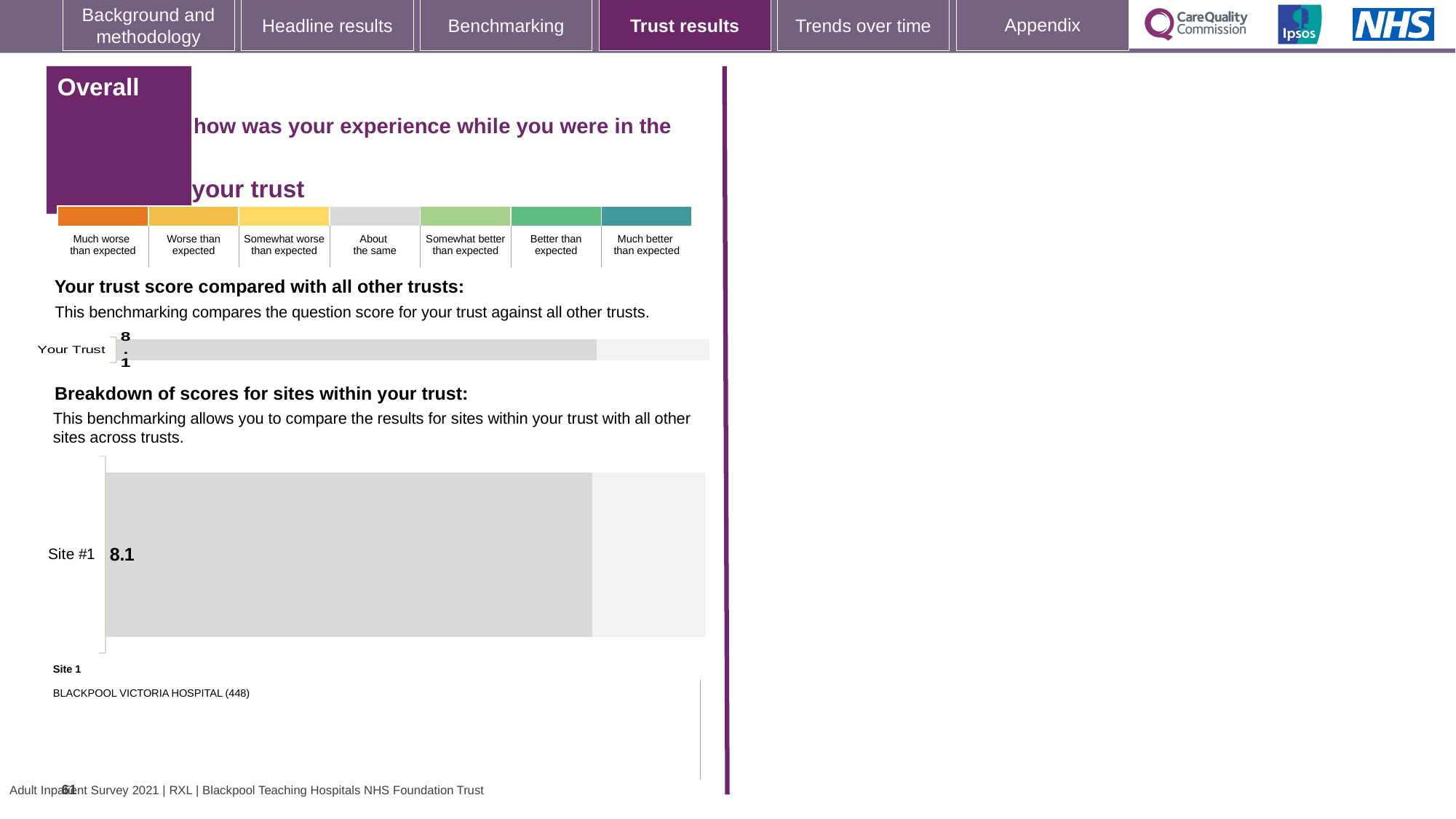
How many bars are plotted in the 'Your trust score compared with all other trusts' chart? 1 What is the label of the single bar in the 'Your trust score compared with all other trusts' chart? Your Trust In the 'Your trust score compared with all other trusts' chart, what is the score for Your Trust? 8.1 In the 'Breakdown of scores for sites within your trust' chart, what is the score for Site #1? 8.1 What kind of chart is the 'Your trust score compared with all other trusts' chart? bar chart What kind of chart is the 'Breakdown of scores for sites within your trust' chart? bar chart What is the label of the single bar in the 'Breakdown of scores for sites within your trust' chart? Site #1 Is the score for Your Trust in the 'Your trust score compared with all other trusts' chart greater or less than 10? less How many sites are plotted in the 'Breakdown of scores for sites within your trust' chart? 1 Is the score for Site #1 in the 'Breakdown of scores for sites within your trust' chart greater or less than 5? greater Which hospital is listed as Site 1 below the 'Breakdown of scores for sites within your trust' chart? BLACKPOOL VICTORIA HOSPITAL (448)